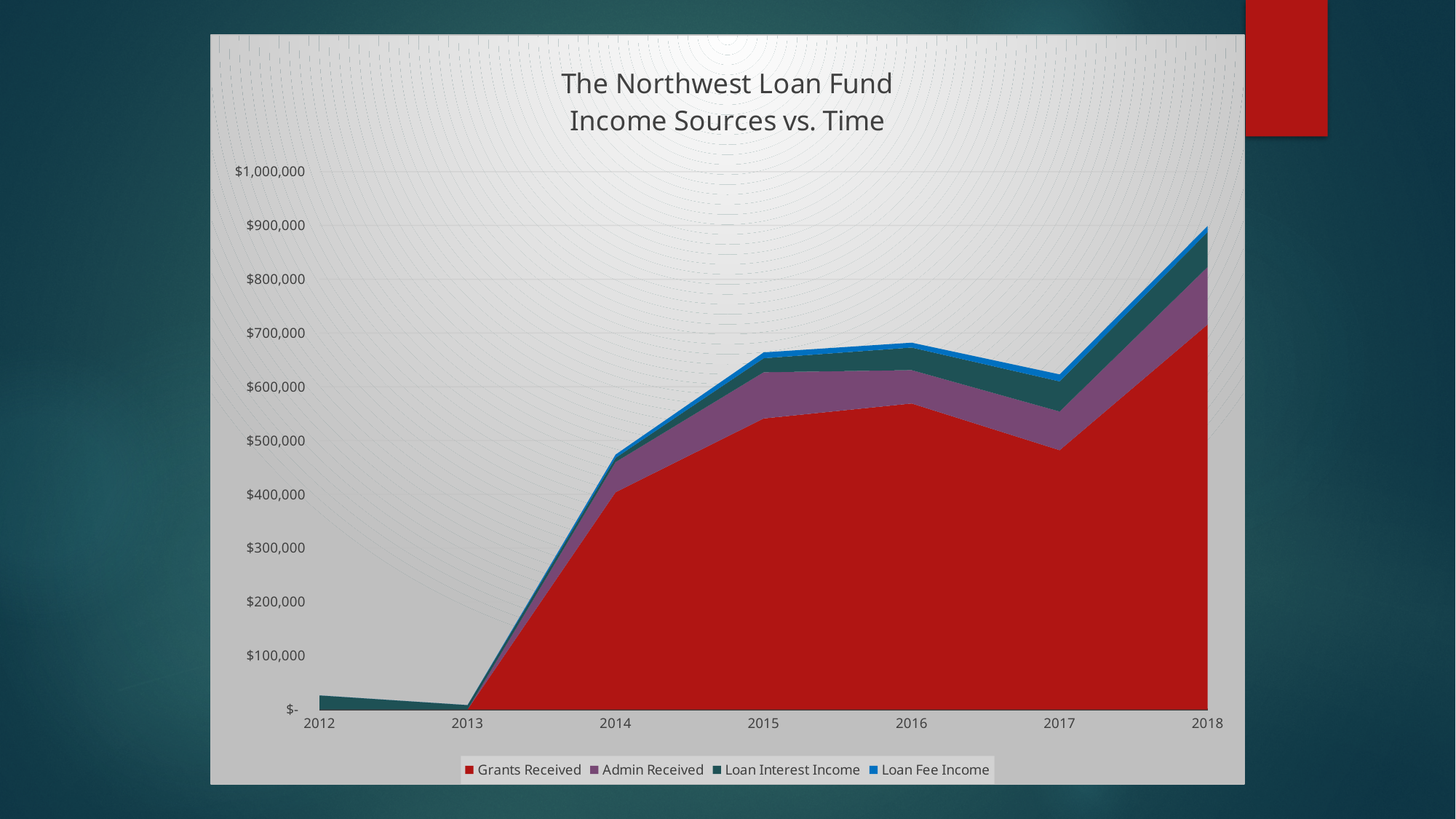
What kind of chart is shown on the slide? Stacked area chart Does total income rise or fall from 2013 to 2015? rise How many years are shown along the x axis? 7 How many series does the legend list? 4 Is the total income in 2012 greater or less than $100,000? less Is the value for Grants Received in 2017 greater or less than $500,000? less Which year has the lowest total income? 2013 Which series is shown in red? Grants Received Is the value for Grants Received in 2015 greater or less than $500,000? greater Which year has the highest total income? 2018 Which year has the larger total income, 2016 or 2018? 2018